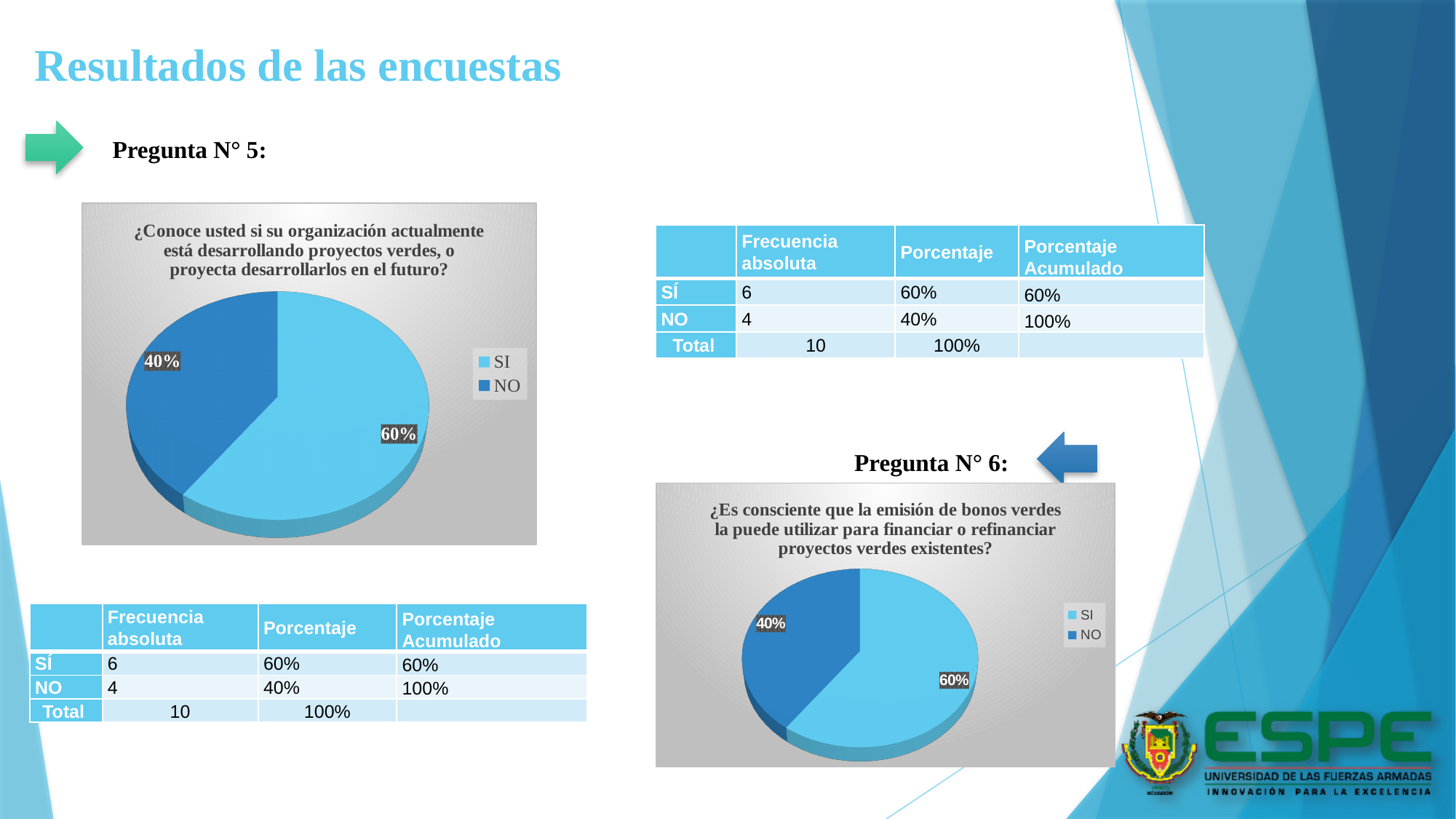
In the Pregunta N° 6 pie chart, what percentage is shown for SI? 60% In the Pregunta N° 5 pie chart, what percentage is shown for NO? 40% In the Pregunta N° 5 pie chart, what percentage is shown for SI? 60% In the Pregunta N° 6 pie chart, is the slice for SI larger or smaller than the slice for NO? larger In the Pregunta N° 5 pie chart, what is the difference in percentage points between SI and NO? 20 How many entries does the legend of the Pregunta N° 5 pie chart list? 2 What type of chart is used for Pregunta N° 5? pie chart In the Pregunta N° 5 pie chart, which category has the largest slice? SI How many categories does the Pregunta N° 6 pie chart show? 2 In the Pregunta N° 6 pie chart, which category has the smallest slice? NO In the Pregunta N° 6 pie chart, what share of the pie does the NO slice represent? 40% In the Pregunta N° 6 pie chart, what percentage is shown for NO? 40%